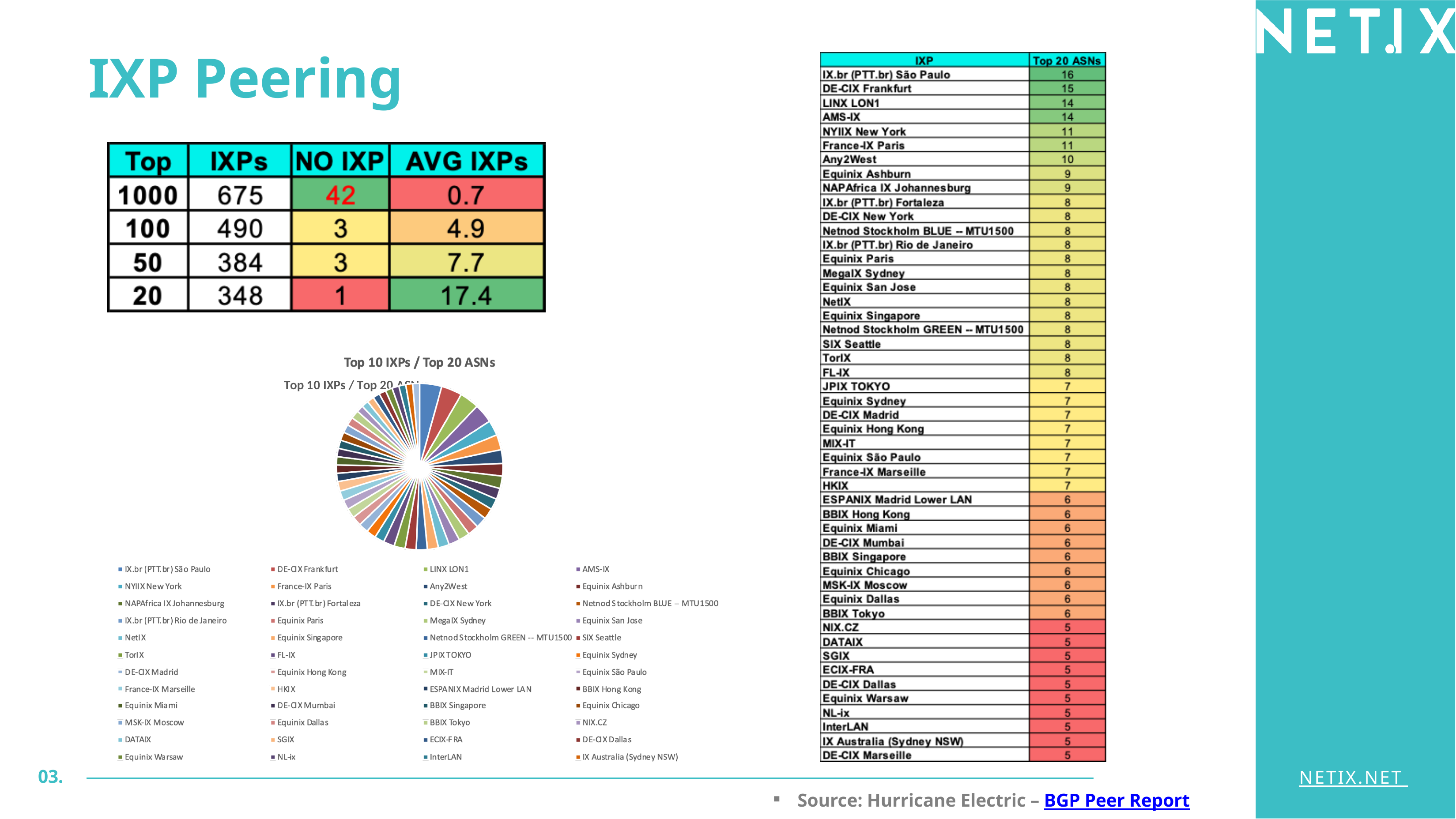
What is the title of the pie chart? Top 10 IXPs / Top 20 ASNs Which IXP is the last entry in the pie chart's legend? IX Australia (Sydney NSW) What kind of chart is shown on the slide? pie chart Which IXP is the first entry in the pie chart's legend? IX.br (PTT.br) São Paulo How many entries does the pie chart's legend list? 48